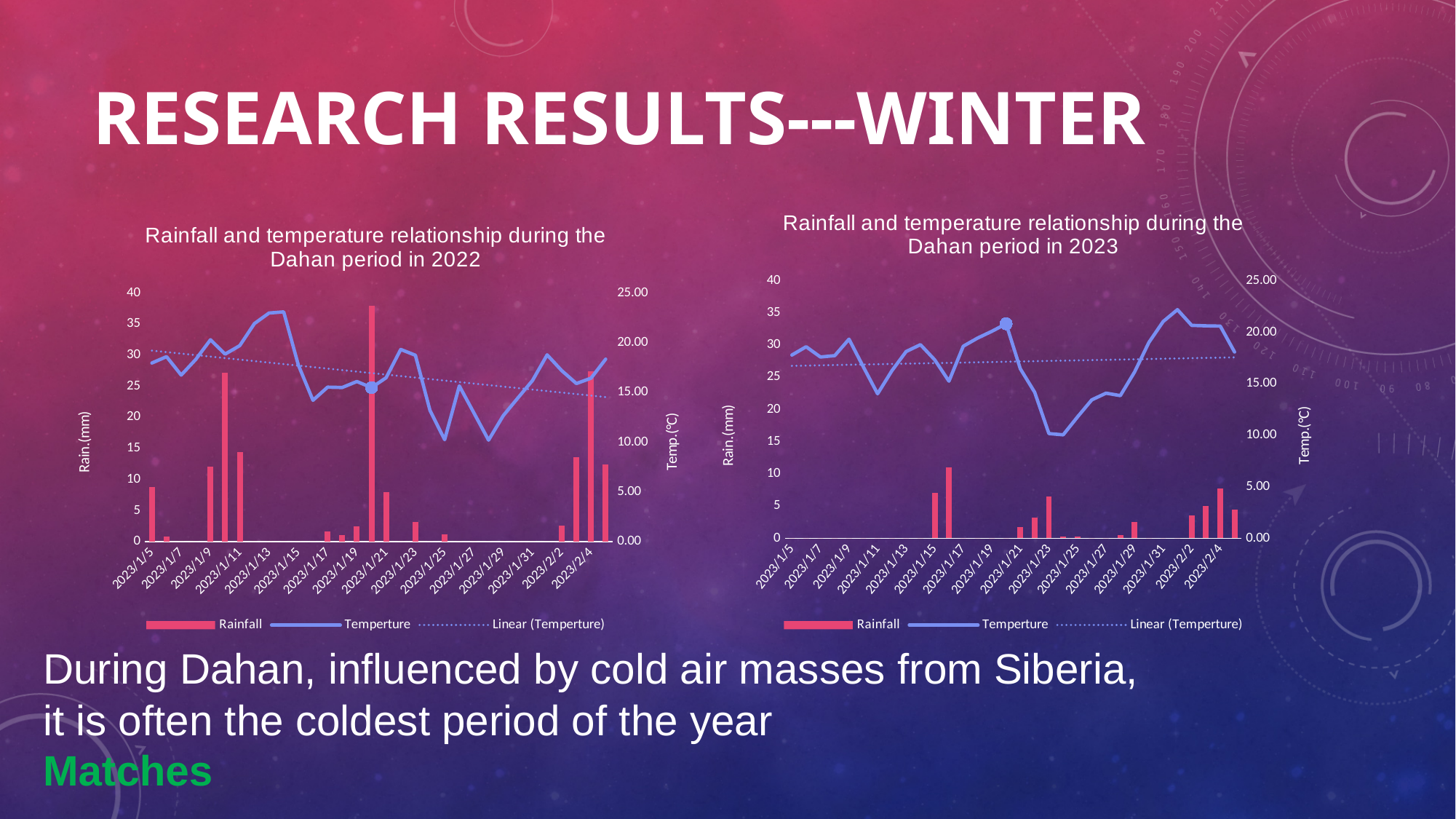
What kind of chart is the 'Rainfall and temperature relationship during the Dahan period in 2022' chart? A combination bar and line chart In the 2022 chart, is the Temperture value for 2023/1/13 greater or less than 20.00? greater How many date labels are shown on the x axis of the 2023 chart? 16 In the 2023 chart, is the Temperture value for 2023/1/25 greater or less than 15.00? less How many series does the legend of the 2023 chart list? 3 What are the legend entries of the 2022 chart? Rainfall, Temperture, Linear (Temperture) In the 2023 chart, which date has the higher Temperture value, 2023/1/25 or 2023/1/31? 2023/1/31 In the 2022 chart, does the Linear (Temperture) trend line rise or fall from left to right? fall In the 2023 chart, is the Rainfall value for 2023/1/17 greater or less than 15? less